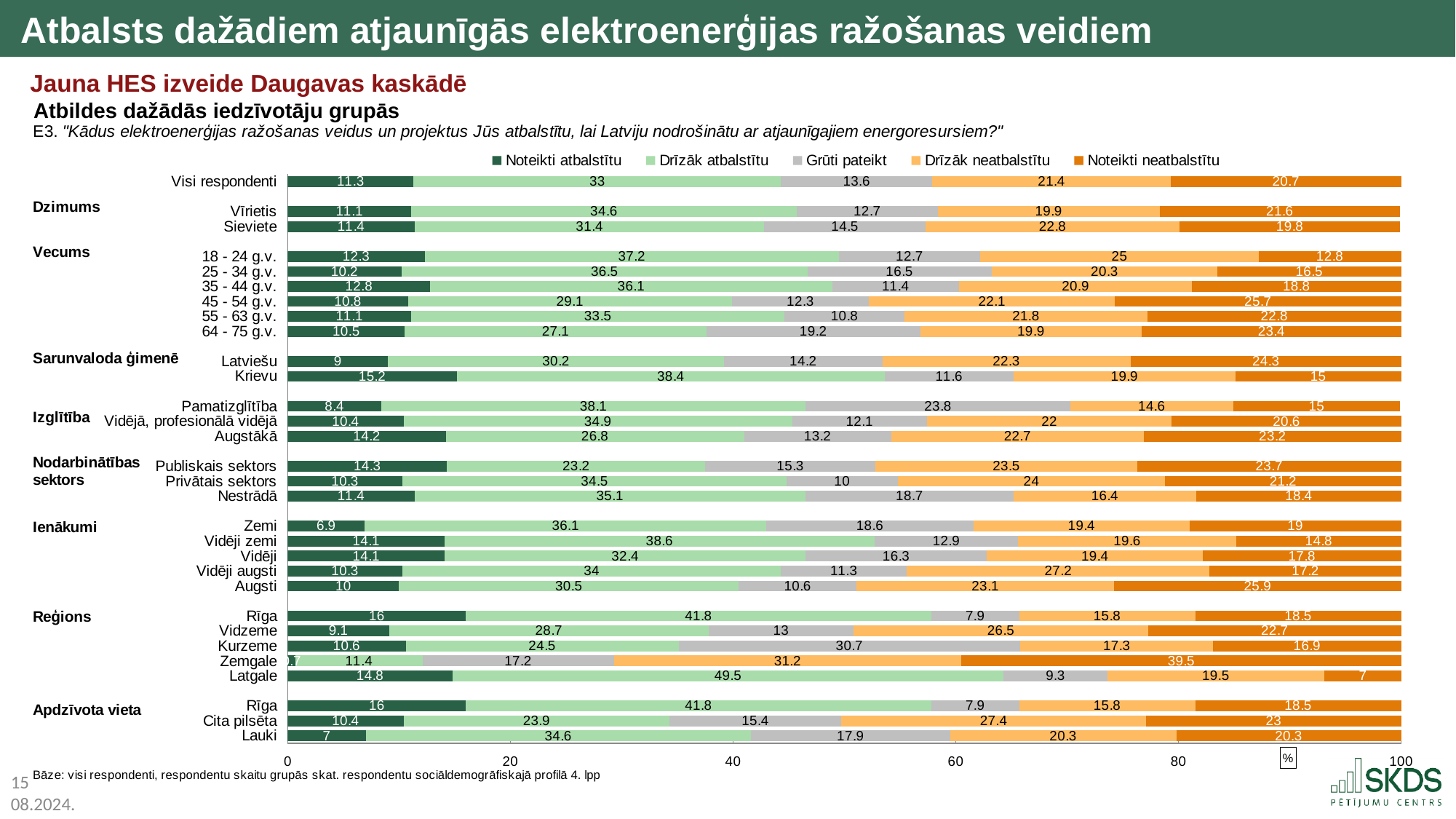
What is the total of the stacked bar for Visi respondenti? 100 Which has the larger value for "Drīzāk atbalstītu", Rīga or Vidzeme? Rīga What is the value of "Grūti pateikt" for Kurzeme? 30.7 How many series does the legend list? 5 Which group has the highest value for "Noteikti neatbalstītu"? Zemgale What kind of chart is shown on the slide? Stacked bar chart What is the value of "Drīzāk neatbalstītu" for Zemgale? 31.2 What is the difference between Vīrietis and Sieviete for "Drīzāk atbalstītu"? 3.2 What is the value of "Noteikti neatbalstītu" for Augsti? 25.9 Among the Ienākumi groups, which has the lowest value for "Noteikti atbalstītu"? Zemi Which group has the highest value for "Drīzāk atbalstītu"? Latgale What is the value of "Drīzāk atbalstītu" for Visi respondenti? 33